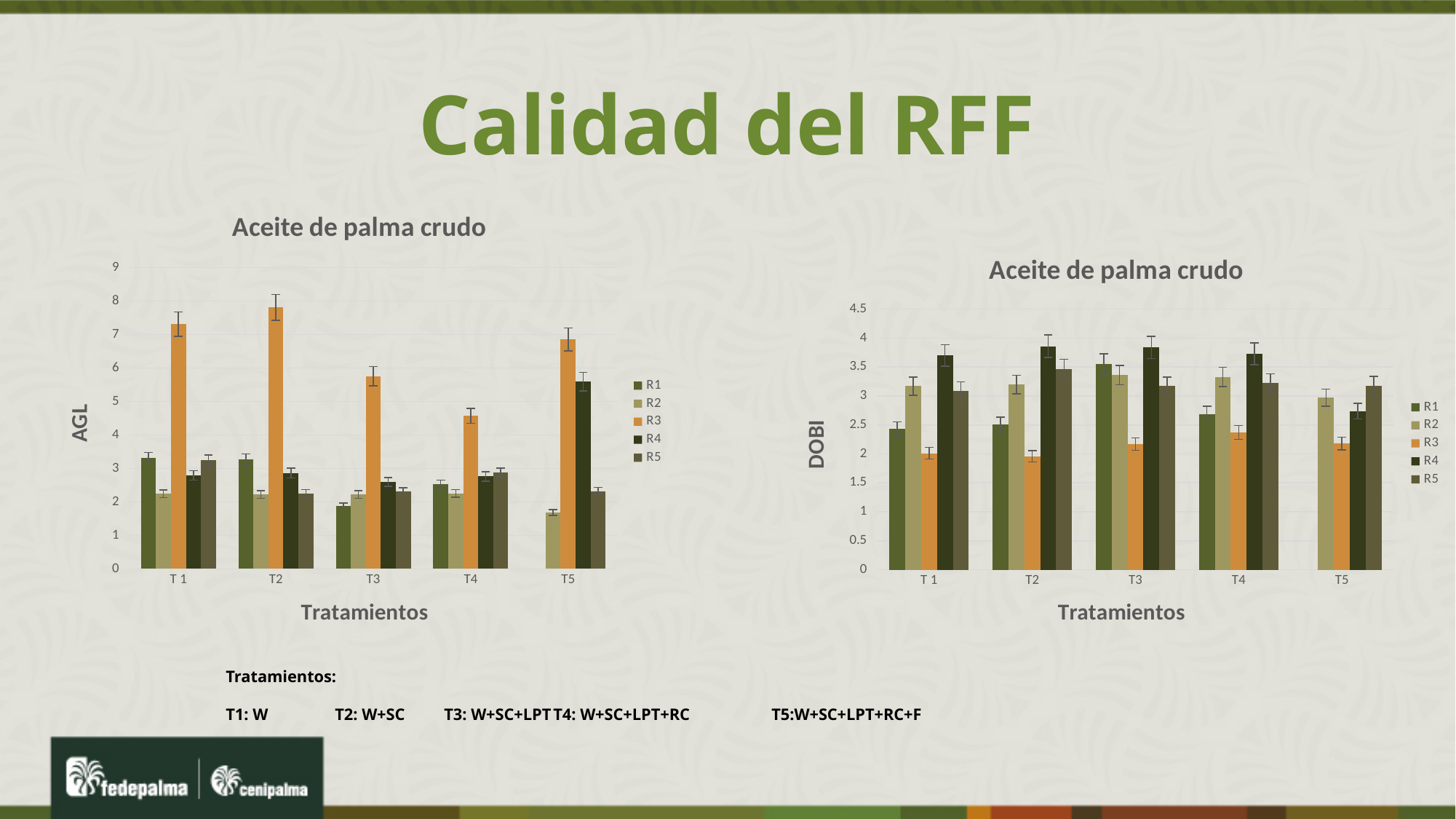
In the left chart (AGL), which series has the lowest value at T5? R2 In the left chart (AGL), is the value for R2 at T5 greater or less than 2? less In the left chart (AGL), is the value for R3 at T2 greater or less than 7? greater What kind of chart is the left chart (AGL)? bar chart In the right chart (DOBI), which series has the lowest value at T2? R3 In the right chart (DOBI), is the value for R4 at T1 greater or less than 3.5? greater How many treatments are shown on the x axis of the left chart (AGL)? 5 In the left chart (AGL), which is larger at T4: R3 or R1? R3 How many series does the legend of the right chart (DOBI) list? 5 What is the y-axis label of the right chart? DOBI In the right chart (DOBI), which is larger at T4: R4 or R3? R4 In the left chart (AGL), which series has the highest value at T2? R3